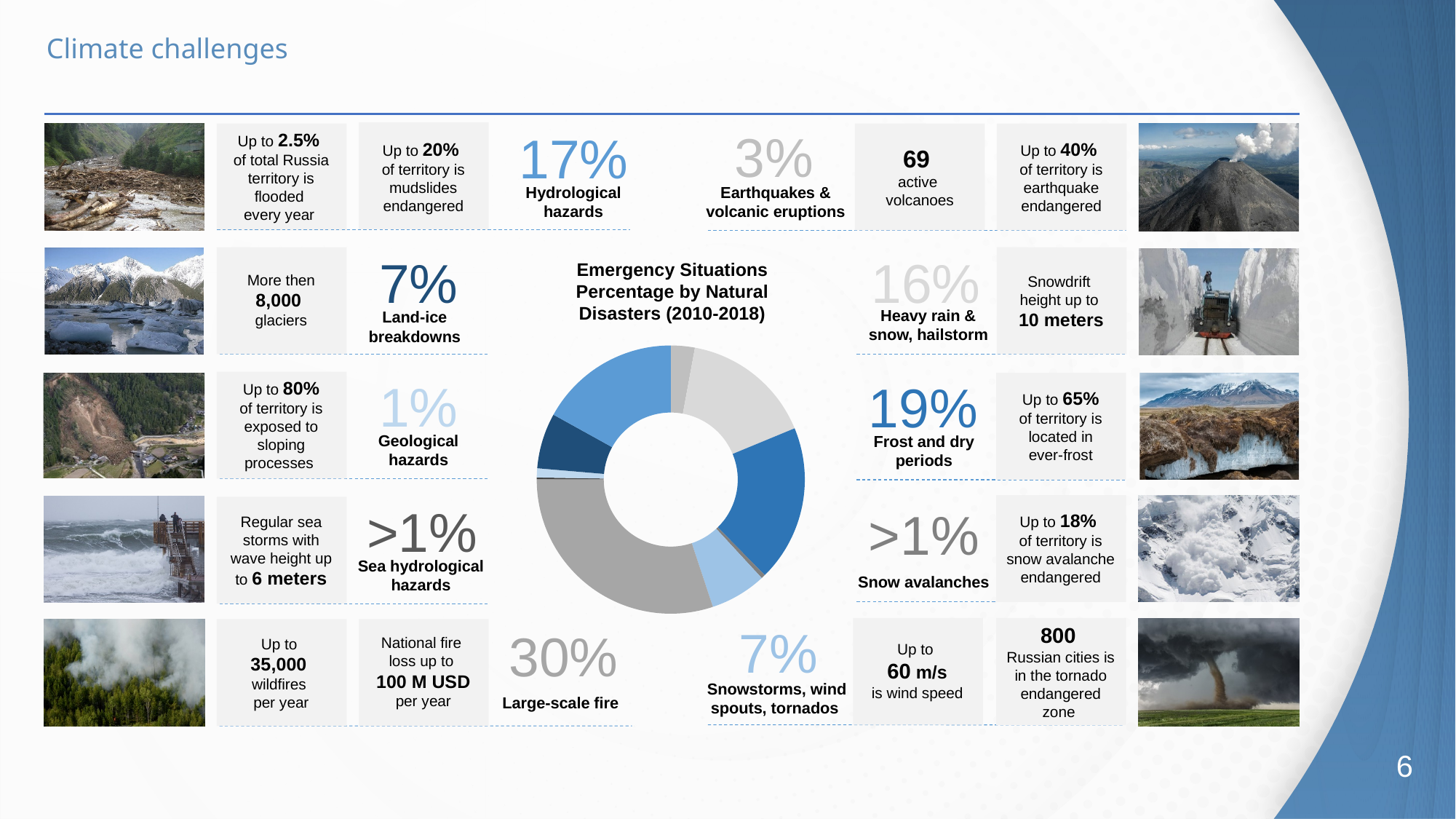
What percentage of emergency situations is attributed to Hydrological hazards? 17% What percentage of emergency situations is attributed to Frost and dry periods? 19% Which has a larger share of emergency situations: Hydrological hazards or Heavy rain & snow, hailstorm? Hydrological hazards What is the difference in percentage between Land-ice breakdowns and Earthquakes & volcanic eruptions? 4% What percentage of emergency situations is attributed to Earthquakes & volcanic eruptions? 3% Which natural disaster category accounts for the largest share of emergency situations? Large-scale fire What is the title of the chart? Emergency Situations Percentage by Natural Disasters (2010-2018) What percentage of emergency situations is attributed to Heavy rain & snow, hailstorm? 16% What is the difference in percentage between Large-scale fire and Frost and dry periods? 11% What kind of chart is shown on the slide? Pie chart (donut) What percentage of emergency situations is attributed to Large-scale fire? 30% How many natural disaster categories are shown around the chart? 10